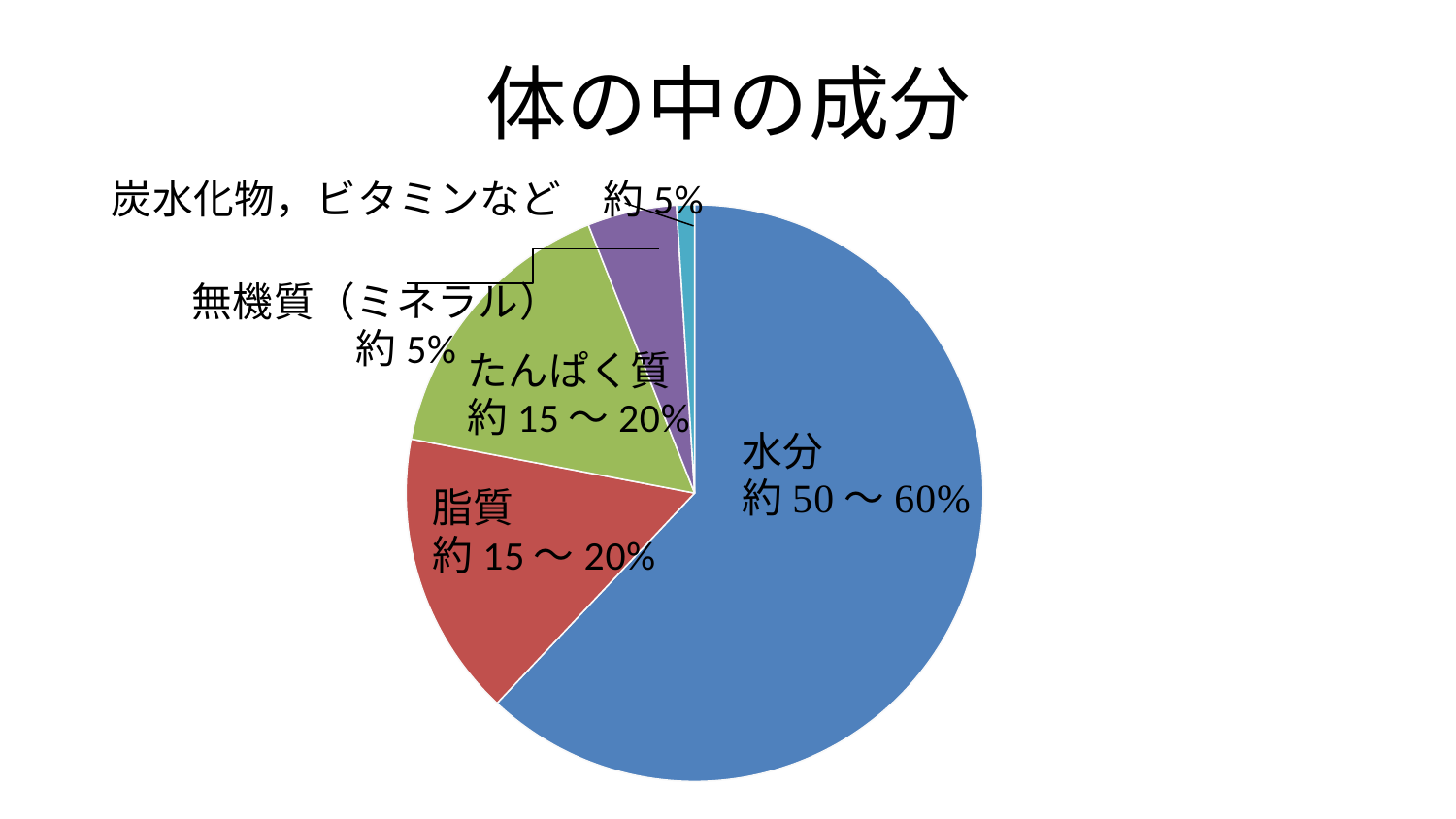
Which component has the largest slice of the pie? 水分 How many slices does the pie chart have? 5 What share is shown for 炭水化物，ビタミンなど? 約 5% What share is shown for たんぱく質? 約 15 ～ 20% What share of the body is 水分 according to the chart? 約 50 ～ 60% What is the title of the chart? 体の中の成分 Which is larger, the slice for 水分 or the slice for 脂質? 水分 What share is shown for 無機質（ミネラル）? 約 5% What share is shown for 脂質? 約 15 ～ 20% What colour is the 水分 slice? blue What type of chart is shown on the slide? pie chart Which is larger, the slice for 脂質 or the slice for 無機質（ミネラル）? 脂質